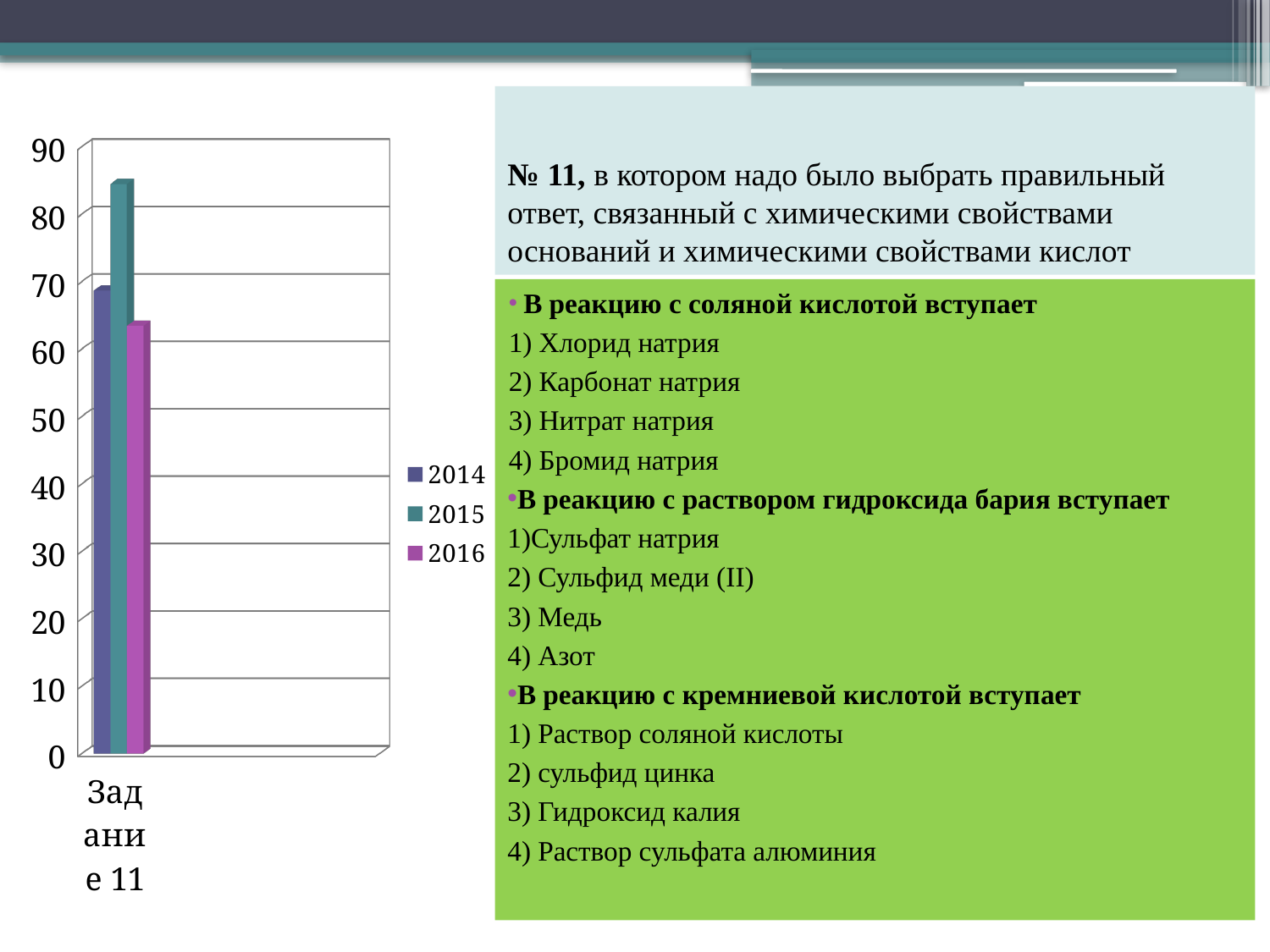
Which is larger for Задание 11, the value for 2014 or the value for 2016? 2014 What is the category label shown on the x axis of the chart? Задание 11 Is the value for 2014 for Задание 11 greater or less than 60? greater Which is larger for Задание 11, the value for 2015 or the value for 2014? 2015 Is the value for 2016 for Задание 11 greater or less than 70? less How many series does the chart legend list? 3 How many categories are shown on the x axis of the chart? 1 Which year has the highest bar for Задание 11? 2015 What kind of chart is shown on the slide? bar chart Which series is shown in purple in the chart legend? 2016 Which year has the lowest bar for Задание 11? 2016 Is the value for 2015 for Задание 11 greater or less than 80? greater